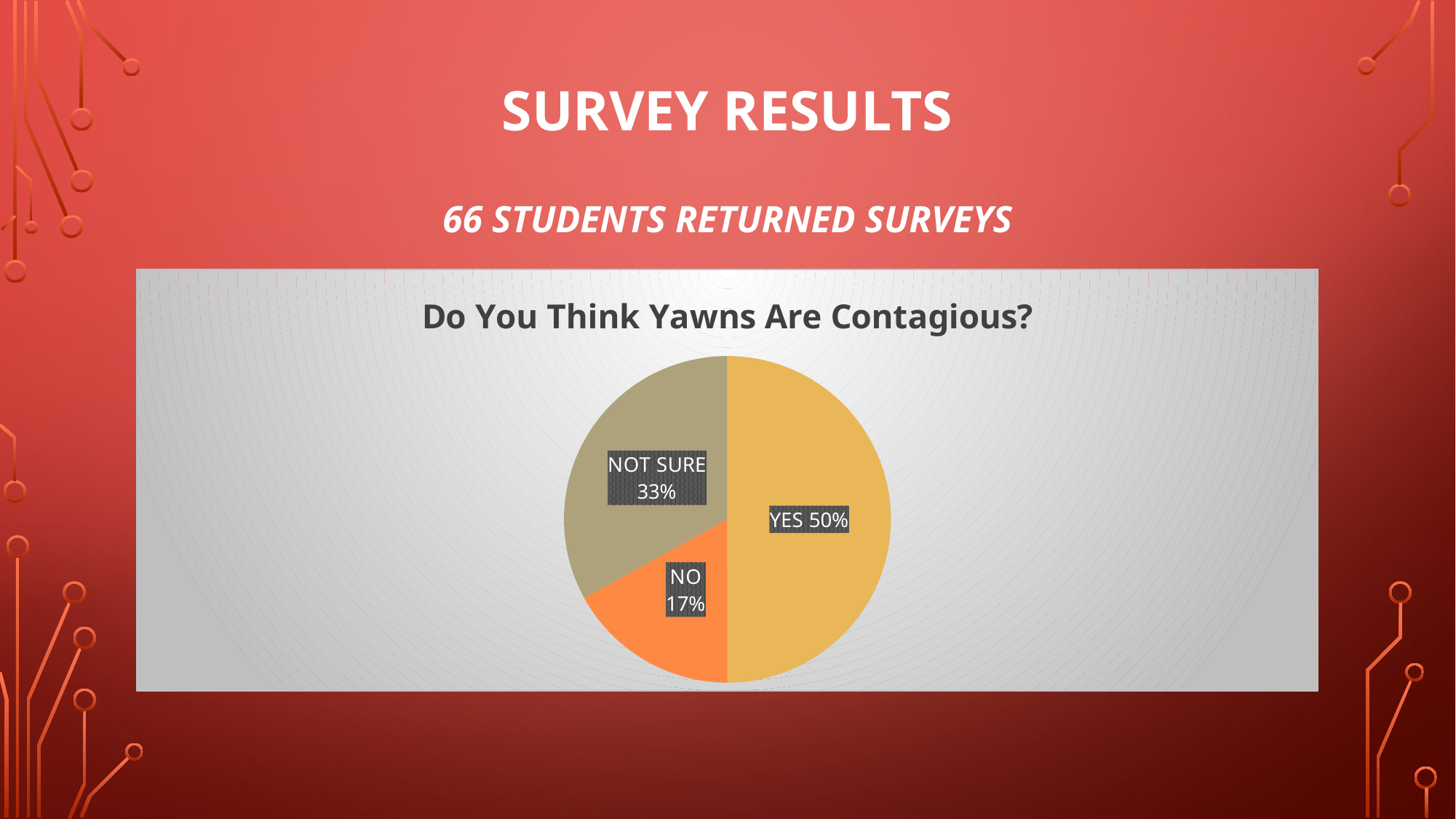
Which response has the smallest share of the pie? NO What is the title of the chart? Do You Think Yawns Are Contagious? What colour is the YES slice? yellow-orange What is the difference in percentage points between YES and NO? 33 Which is larger, the NOT SURE share or the NO share? NOT SURE What is the difference in percentage points between NOT SURE and NO? 16 What percentage of respondents answered NOT SURE? 33% How many slices does the pie chart have? 3 What percentage of respondents answered NO? 17% What kind of chart is shown on the slide? pie chart What percentage of respondents answered YES? 50% Which response has the largest share of the pie? YES